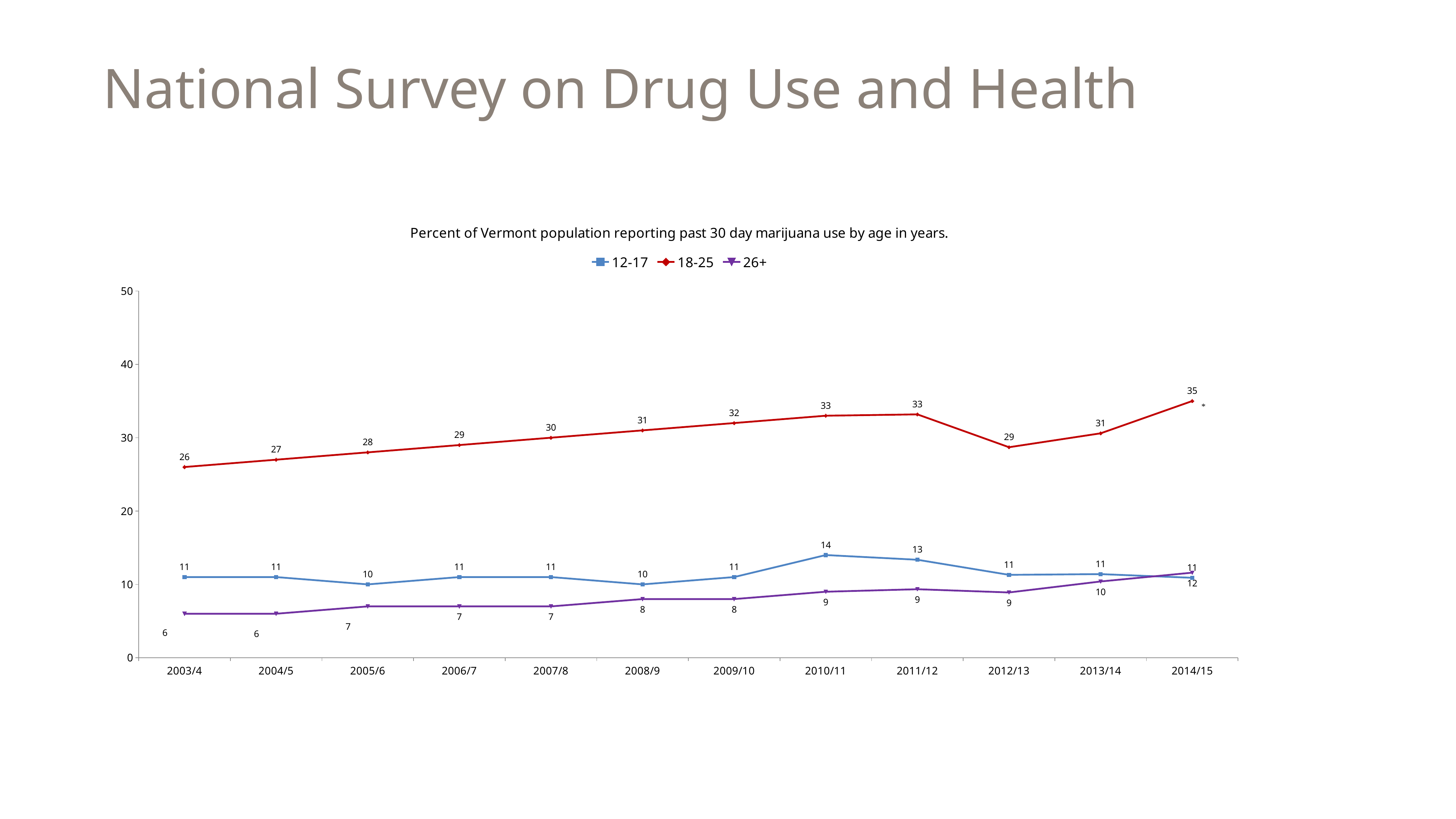
For the 12-17 series, which is larger: the value in 2010/11 or in 2011/12? 2010/11 What is the difference between the 18-25 values in 2014/15 and 2003/4? 9 In which period does the 18-25 series have its lowest value? 2003/4 What is the value for the 18-25 series in 2003/4? 26 What is the value for the 12-17 series in 2010/11? 14 How many series does the legend list? 3 In which period does the 18-25 series reach its highest value? 2014/15 Is the value for the 18-25 series in 2012/13 greater or less than 30? less What is the value for the 26+ series in 2013/14? 10 What is the value for the 18-25 series in 2014/15? 35 How many time periods are shown on the x axis? 12 What kind of chart is shown on the slide? line chart